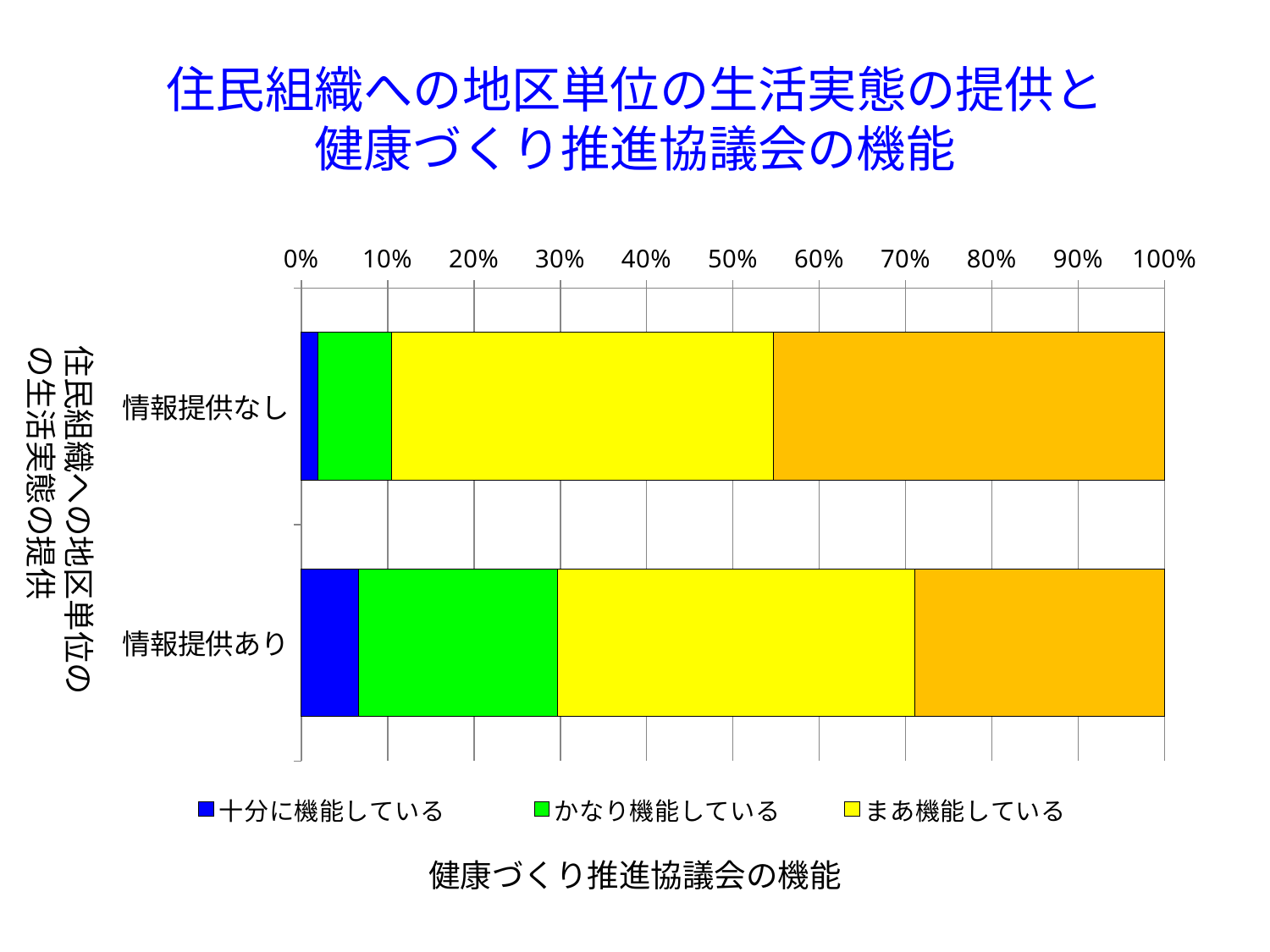
Is the 十分に機能している value for 情報提供あり greater or less than 10%? less Which category has the smaller 十分に機能している value? 情報提供なし How many series does the legend list? 3 Which colour represents 十分に機能している in the legend? blue Is the かなり機能している value for 情報提供あり greater or less than 20%? greater How many categories are plotted on the vertical axis? 2 Which category has the larger かなり機能している value, 情報提供なし or 情報提供あり? 情報提供あり Which category has the larger 十分に機能している value, 情報提供なし or 情報提供あり? 情報提供あり Is the まあ機能している value for 情報提供なし greater or less than 40%? greater What kind of chart is shown on the slide? stacked bar chart What is the title of the horizontal axis? 健康づくり推進協議会の機能